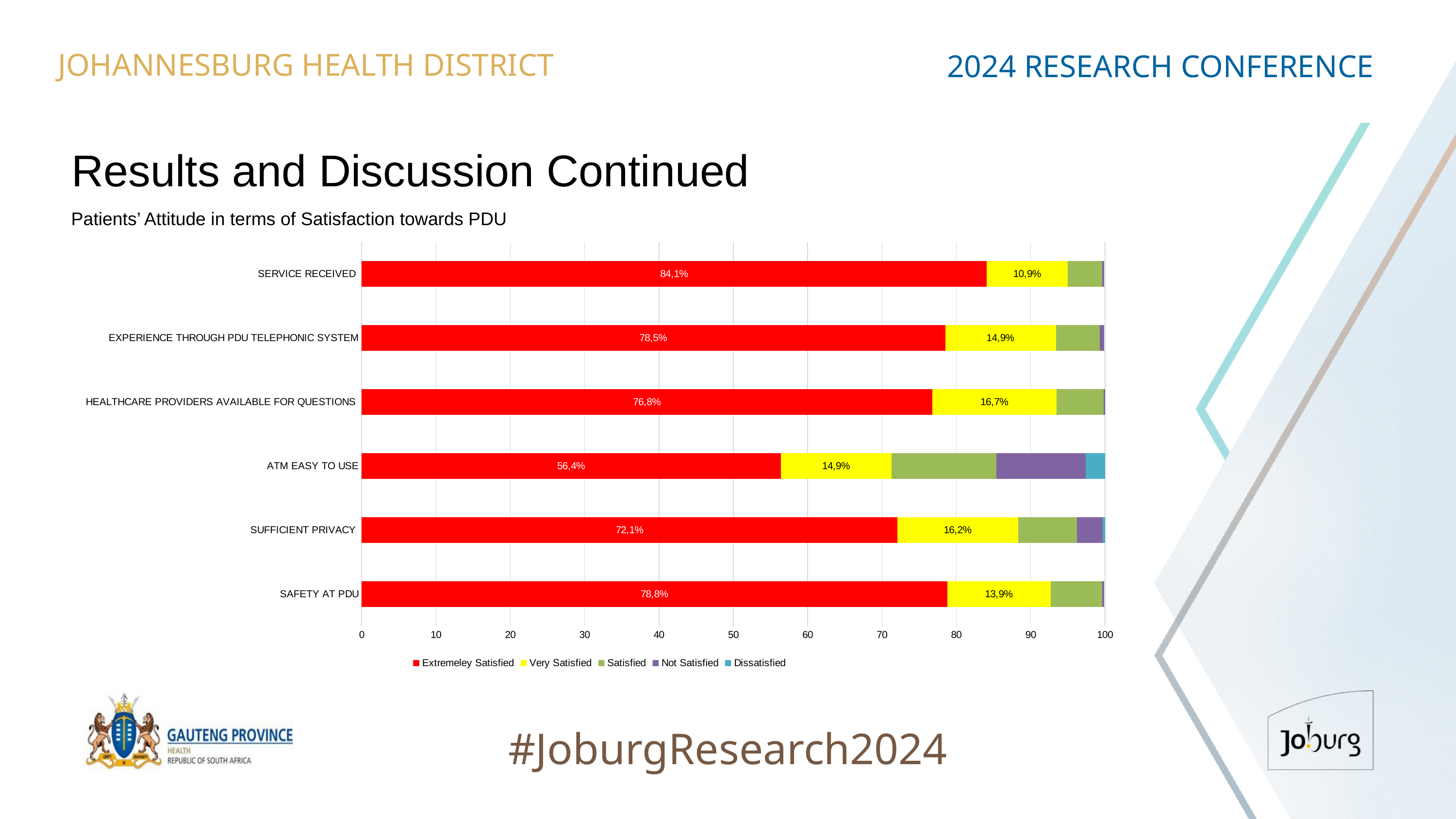
What is the difference between the Extremely Satisfied values for Service Received and ATM Easy to Use? 27,7% What is the Extremely Satisfied value for ATM Easy to Use? 56,4% What is the Extremely Satisfied value for Service Received? 84,1% What is the Extremely Satisfied value for Sufficient Privacy? 72,1% Which has a larger Extremely Satisfied value, Sufficient Privacy or Healthcare Providers Available for Questions? Healthcare Providers Available for Questions How many series does the legend list? 5 Which category has the lowest Very Satisfied value? Service Received What is the Very Satisfied value for Safety at PDU? 13,9% How many categories are shown on the chart? 6 Which category has the highest Extremely Satisfied value? Service Received Which category has the lowest Extremely Satisfied value? ATM Easy to Use What is the Very Satisfied value for Healthcare Providers Available for Questions? 16,7%